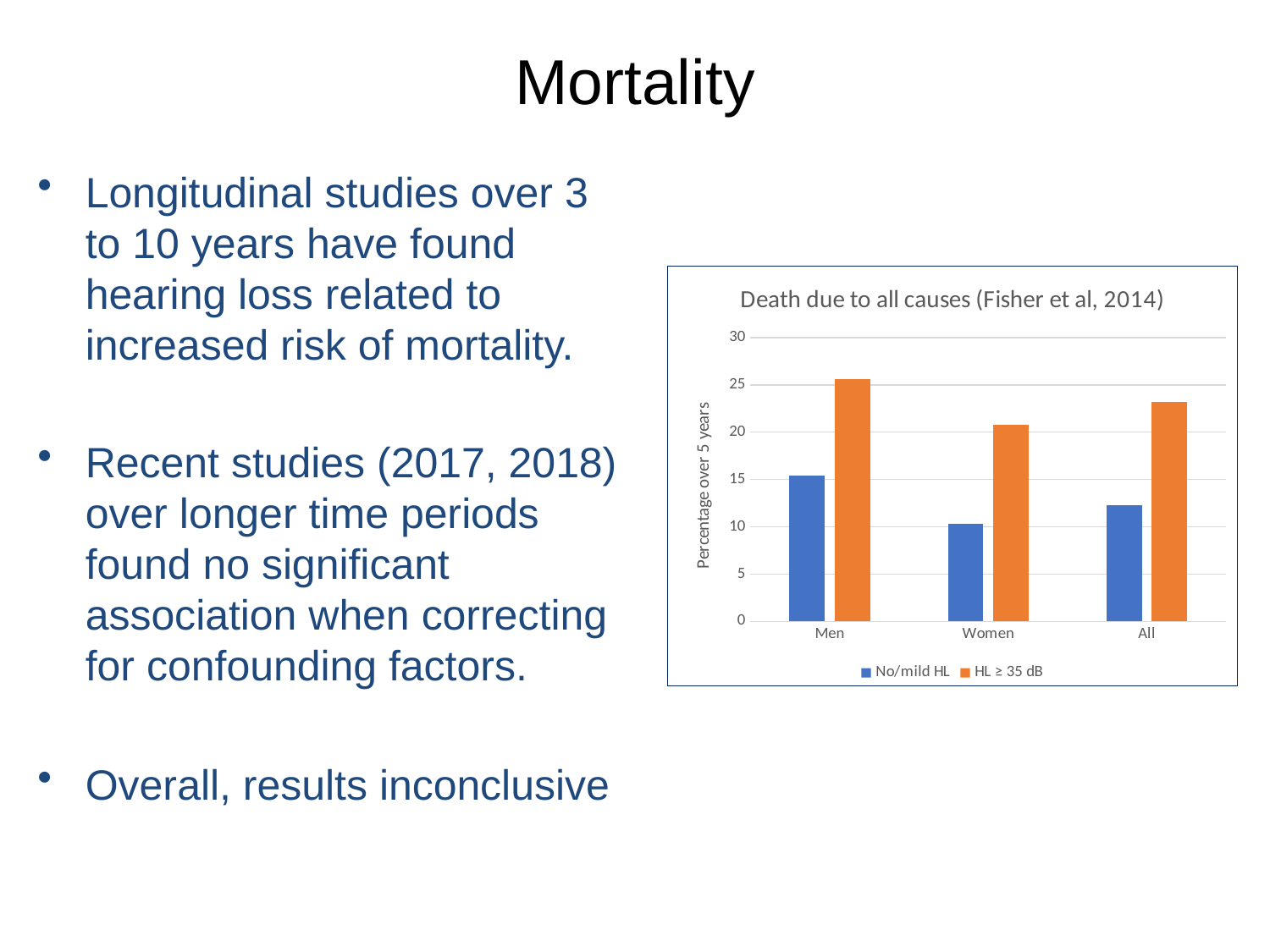
Is the value for Women in the No/mild HL series greater or less than 15? less How many categories are shown on the x axis of the chart? 3 For Women, which series has the larger value: No/mild HL or HL ≥ 35 dB? HL ≥ 35 dB Is the value for All in the HL ≥ 35 dB series greater or less than 20? greater What is the title of the chart? Death due to all causes (Fisher et al, 2014) How many series does the chart legend list? 2 Which category has the highest value for the HL ≥ 35 dB series? Men What is the label of the y axis? Percentage over 5 years What type of chart is shown on the slide? bar chart Which category has the lowest value for the No/mild HL series? Women Which is larger: the No/mild HL value for Men or the No/mild HL value for All? Men